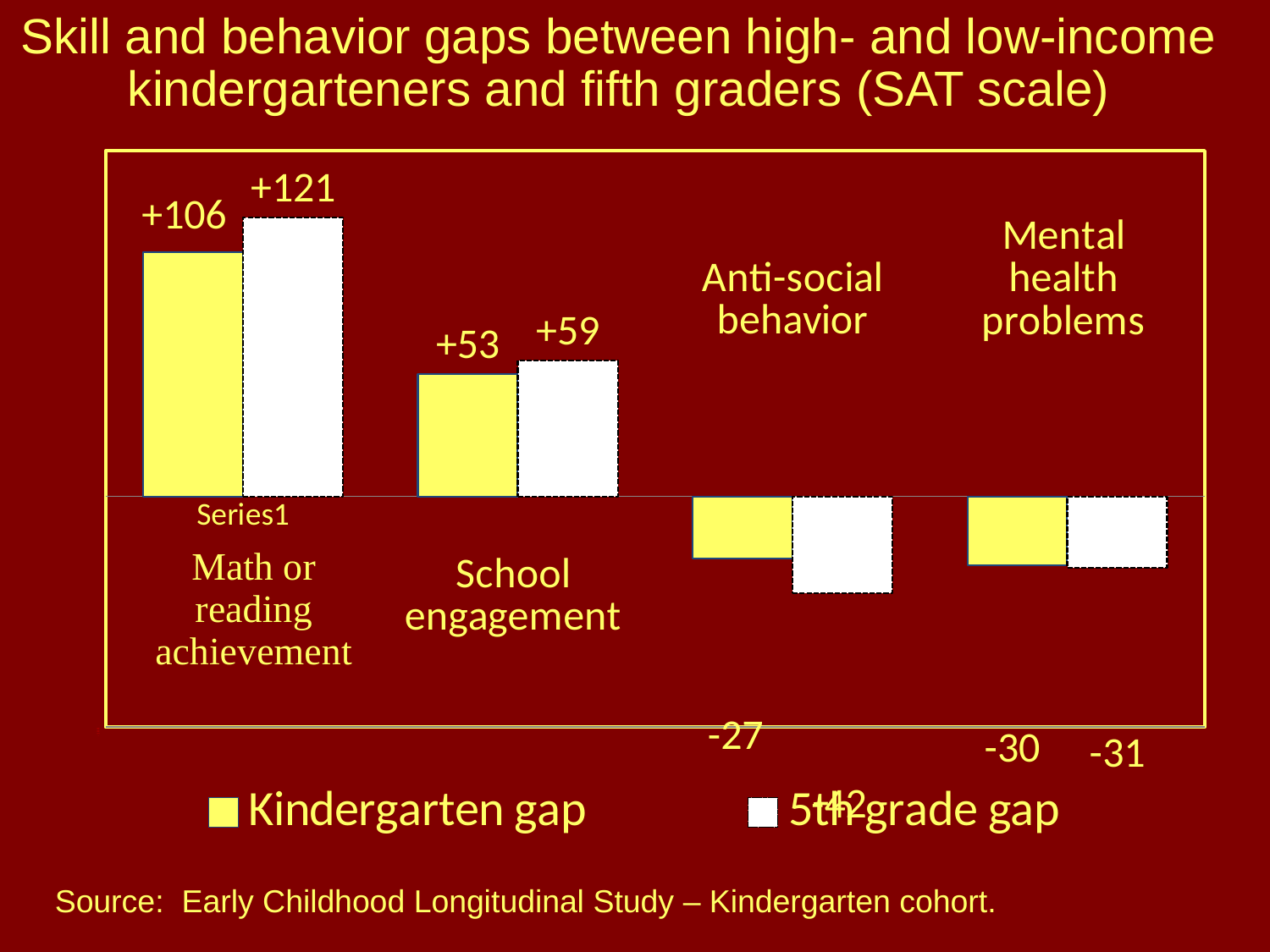
What is the kindergarten gap for School engagement? +53 Which category has the highest 5th grade gap? Math or reading achievement What is the kindergarten gap for Math or reading achievement? +106 How many series does the legend list? 2 What kind of chart is shown on the slide? Bar chart How many categories are shown on the chart? 4 Which is larger in magnitude for Anti-social behavior, the kindergarten gap or the 5th grade gap? 5th grade gap What is the 5th grade gap for Mental health problems? -31 What is the 5th grade gap for School engagement? +59 What is the kindergarten gap for Anti-social behavior? -27 What is the difference between the 5th grade gap and the kindergarten gap for Math or reading achievement? 15 What is the 5th grade gap for Math or reading achievement? +121